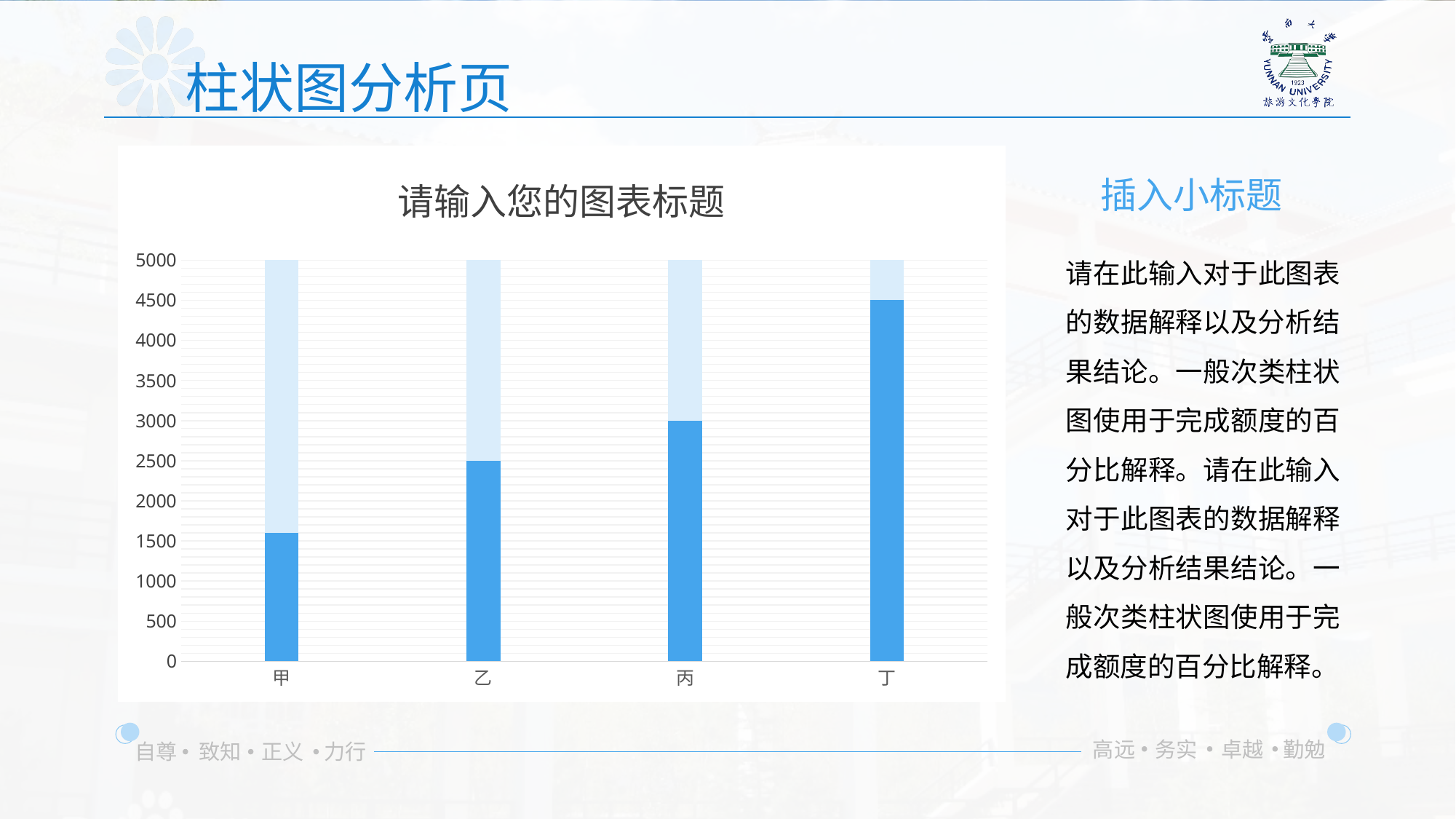
What kind of chart is shown on the slide? bar chart What is the total height of the stacked bar for 乙? 5000 What is the value of the dark blue segment for 乙? 2500 Is the dark blue value for 甲 greater or less than 2000? less Which has a larger dark blue segment, 乙 or 丙? 丙 How many categories are shown on the x axis of the chart? 4 What is the value of the dark blue segment for 丁? 4500 What is the value of the dark blue segment for 丙? 3000 What is the difference between the dark blue values for 丁 and 丙? 1500 Which category has the highest dark blue segment? 丁 Which category has the lowest dark blue segment? 甲 Do the dark blue values rise or fall from 甲 to 丁? rise